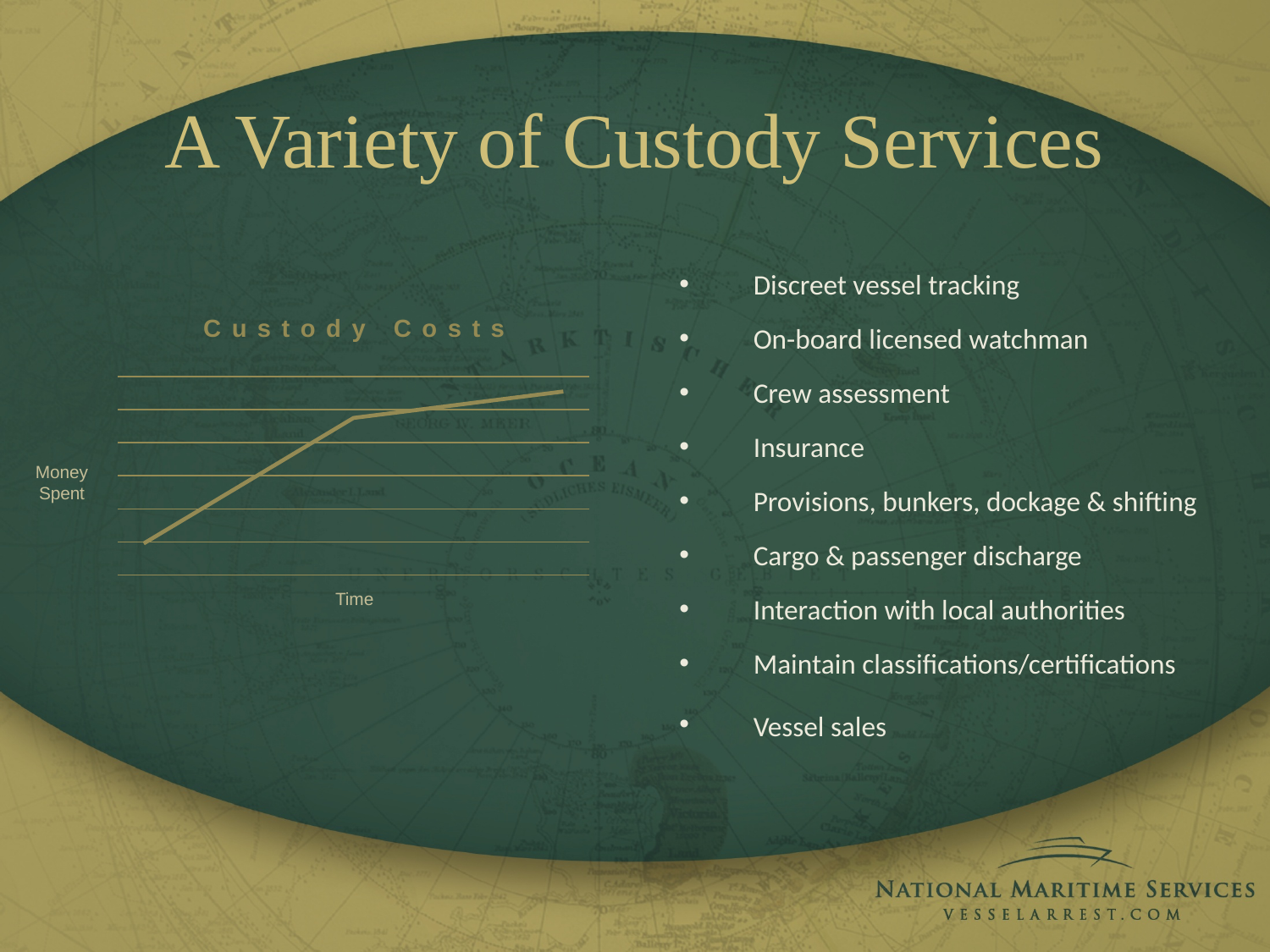
What label is shown on the vertical axis of the chart? Money Spent In the Custody Costs chart, is the value at the right end of the line higher or lower than at the left end? higher Do the values in the Custody Costs chart rise or fall along the x axis? rise What is the title of the chart? Custody Costs What kind of chart is shown on the slide? line chart How many lines are plotted in the Custody Costs chart? 1